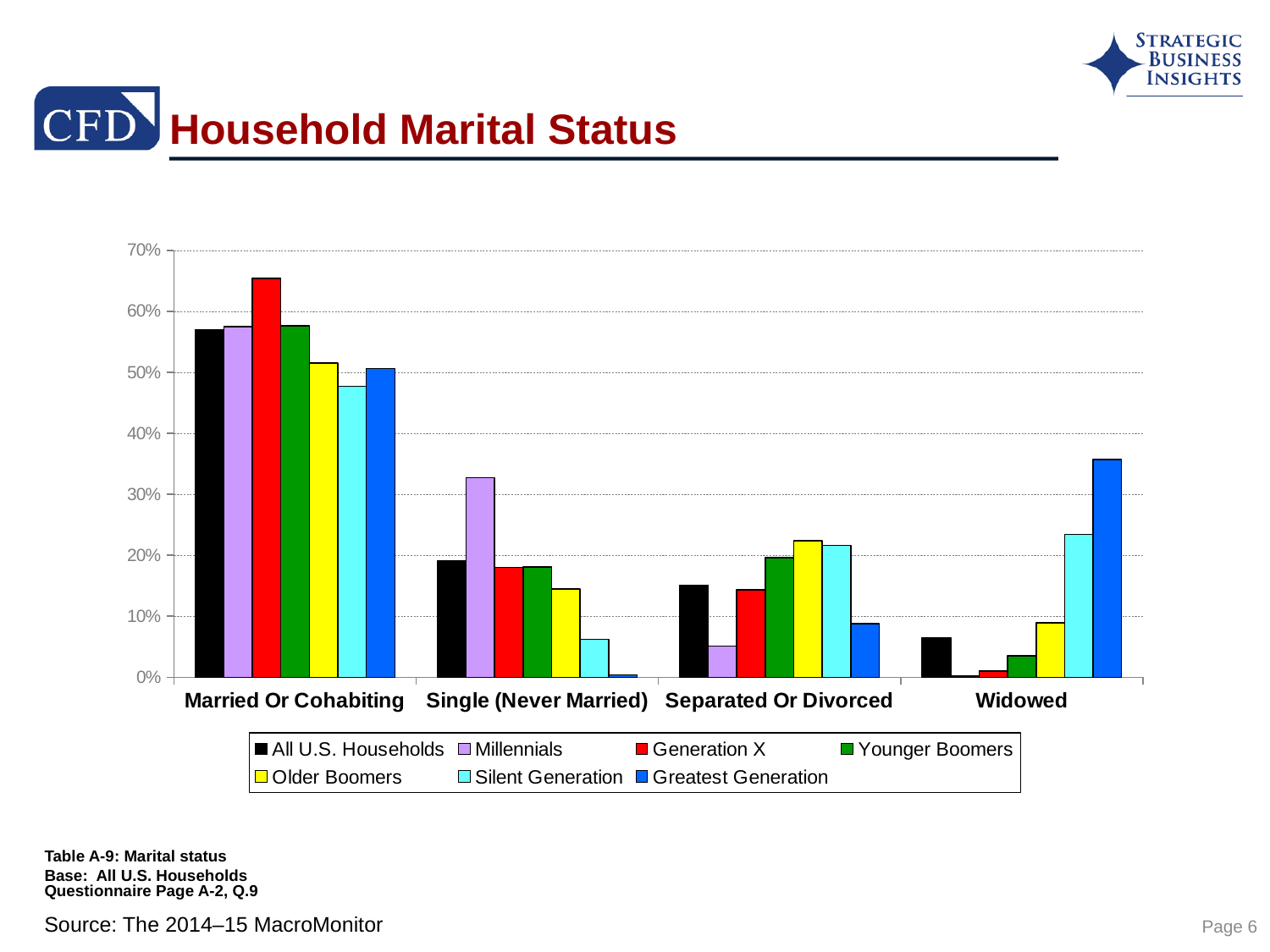
Is the value for Generation X in Married Or Cohabiting greater or less than 60%? greater What kind of chart is shown on the slide? bar chart What is the title of the chart? Household Marital Status Which series has the lowest value for Single (Never Married)? Greatest Generation Which series has the highest value for Single (Never Married)? Millennials How many marital status categories are shown on the x axis? 4 Is the value for Greatest Generation in Widowed greater or less than 30%? greater Which series has the highest value for Widowed? Greatest Generation How many series does the legend list? 7 Which series has the highest value for Married Or Cohabiting? Generation X Is the value for Millennials in Single (Never Married) greater or less than 30%? greater For Separated Or Divorced, which is larger: Older Boomers or Millennials? Older Boomers